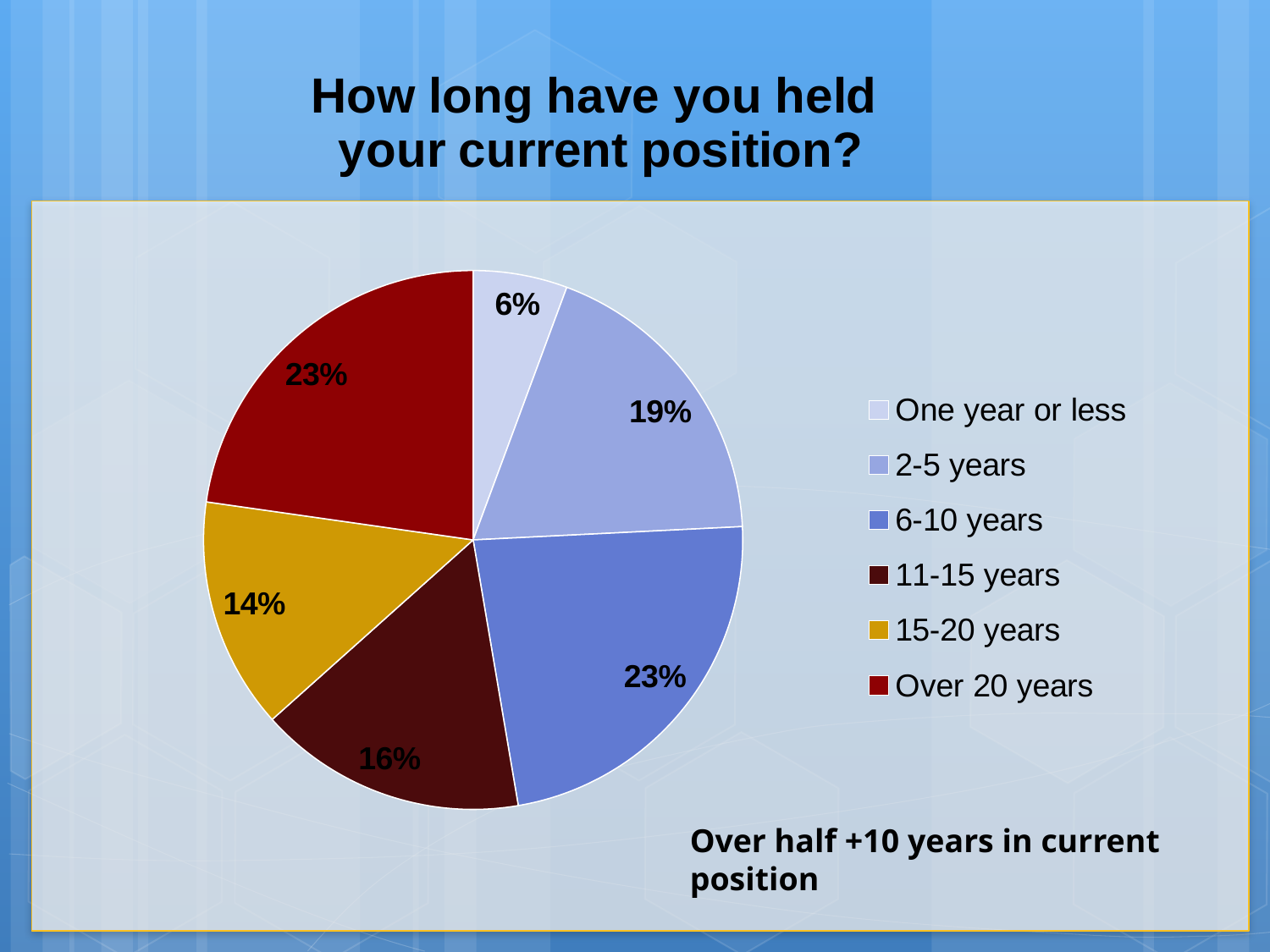
Which is larger, the share for 2-5 years or the share for 11-15 years? 2-5 years Which category has the smallest share of the pie? One year or less What is the difference in percentage points between the 6-10 years slice and the 15-20 years slice? 9 How many categories does the legend list? 6 What colour is the slice for 15-20 years? Gold/yellow What is the title of the chart? How long have you held your current position? What percentage of respondents have held their current position for 2-5 years? 19% What share of respondents have held their current position for one year or less? 6% What percentage of respondents have held their current position for 15-20 years? 14% What type of chart is shown on the slide? Pie chart What percentage of respondents have held their current position for over 20 years? 23% What percentage of respondents have held their current position for 11-15 years? 16%